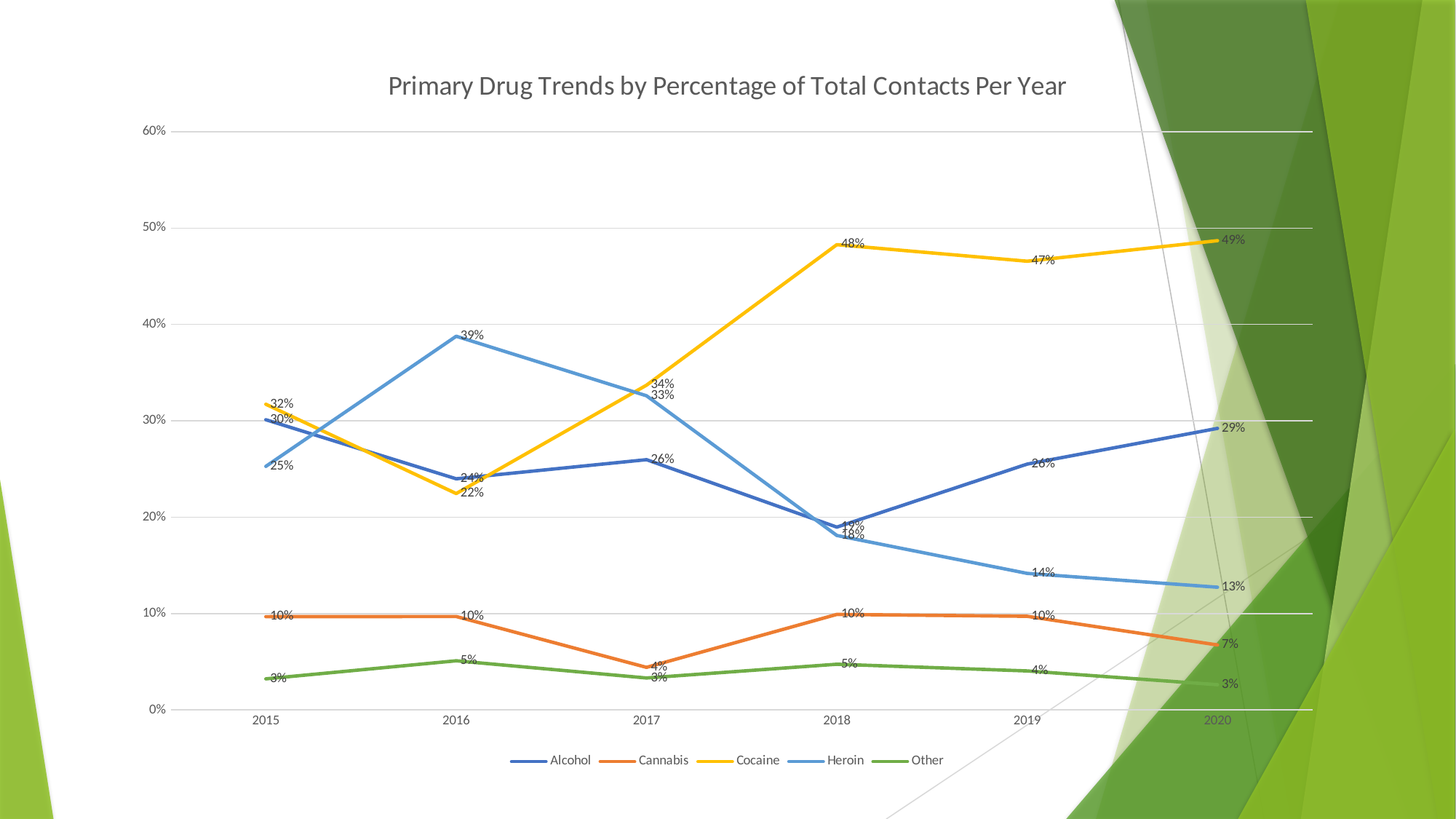
What is the difference between the Cocaine and Heroin values in 2020? 36% What kind of chart is shown on the slide? Line chart Which series has the lowest value in 2015? Other Does the Heroin line rise or fall from 2016 to 2020? Fall What is the title of the chart? Primary Drug Trends by Percentage of Total Contacts Per Year What is the value for Alcohol in 2020? 29% Which series has the highest value in 2020? Cocaine In 2016, which is larger, the value for Heroin or the value for Alcohol? Heroin What is the value for Cocaine in 2018? 48% What is the value for Heroin in 2016? 39% How many years are shown on the x axis? 6 How many series does the legend list? 5